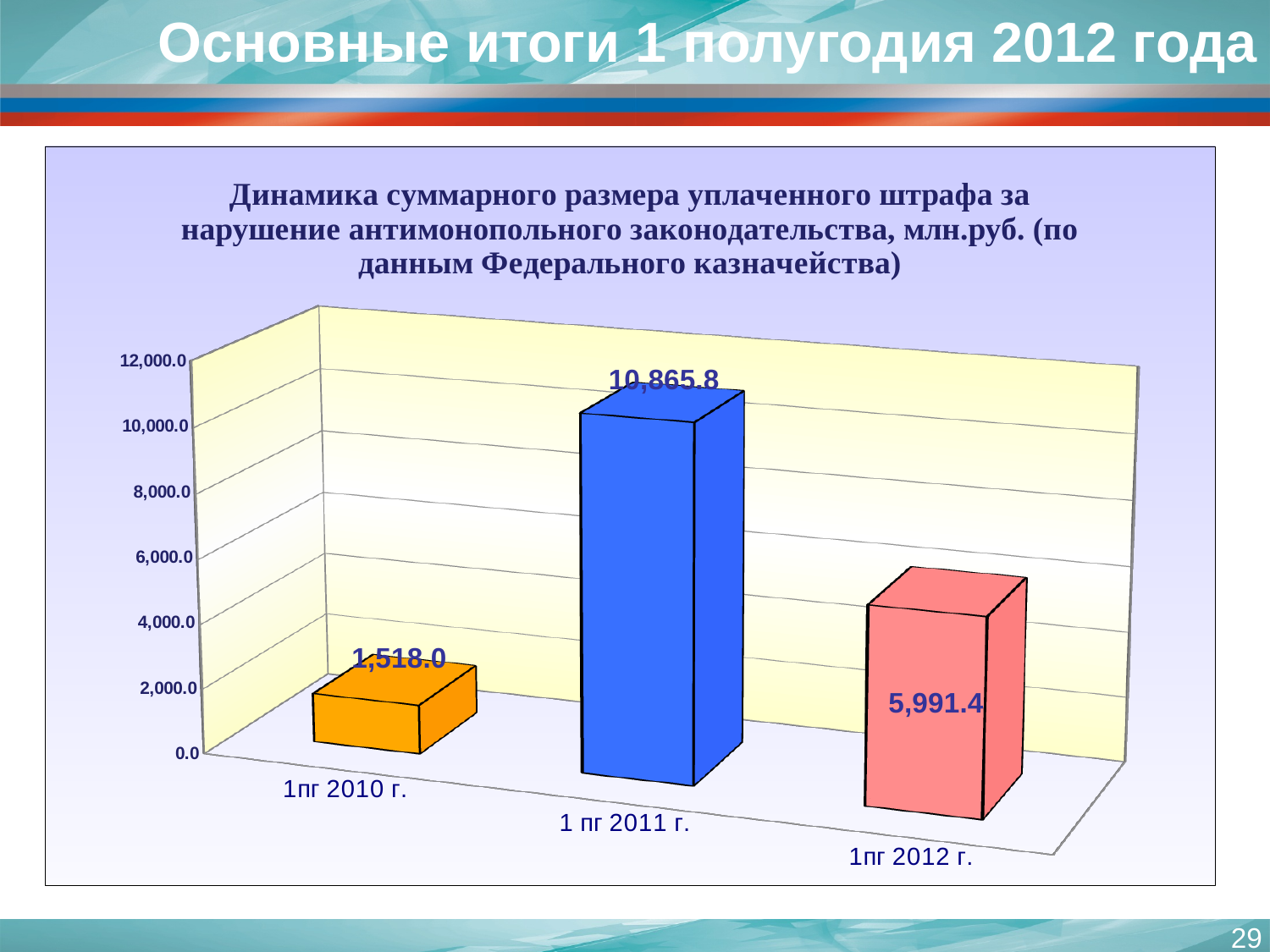
What is the difference between the values for 1 пг 2011 г. and 1пг 2012 г.? 4,874.4 Which period has the highest value? 1 пг 2011 г. Which period has the lowest value? 1пг 2010 г. How many periods are shown on the chart? 3 What is the value for 1 пг 2011 г.? 10,865.8 What kind of chart is shown on the slide? bar chart Which is larger, the value for 1пг 2012 г. or the value for 1пг 2010 г.? 1пг 2012 г. What is the value for 1пг 2010 г.? 1,518.0 What is the value for 1пг 2012 г.? 5,991.4 Do the values rise or fall from 1 пг 2011 г. to 1пг 2012 г.? fall What is the difference between the values for 1пг 2012 г. and 1пг 2010 г.? 4,473.4 Is the value for 1 пг 2011 г. greater or less than 10,000.0? greater